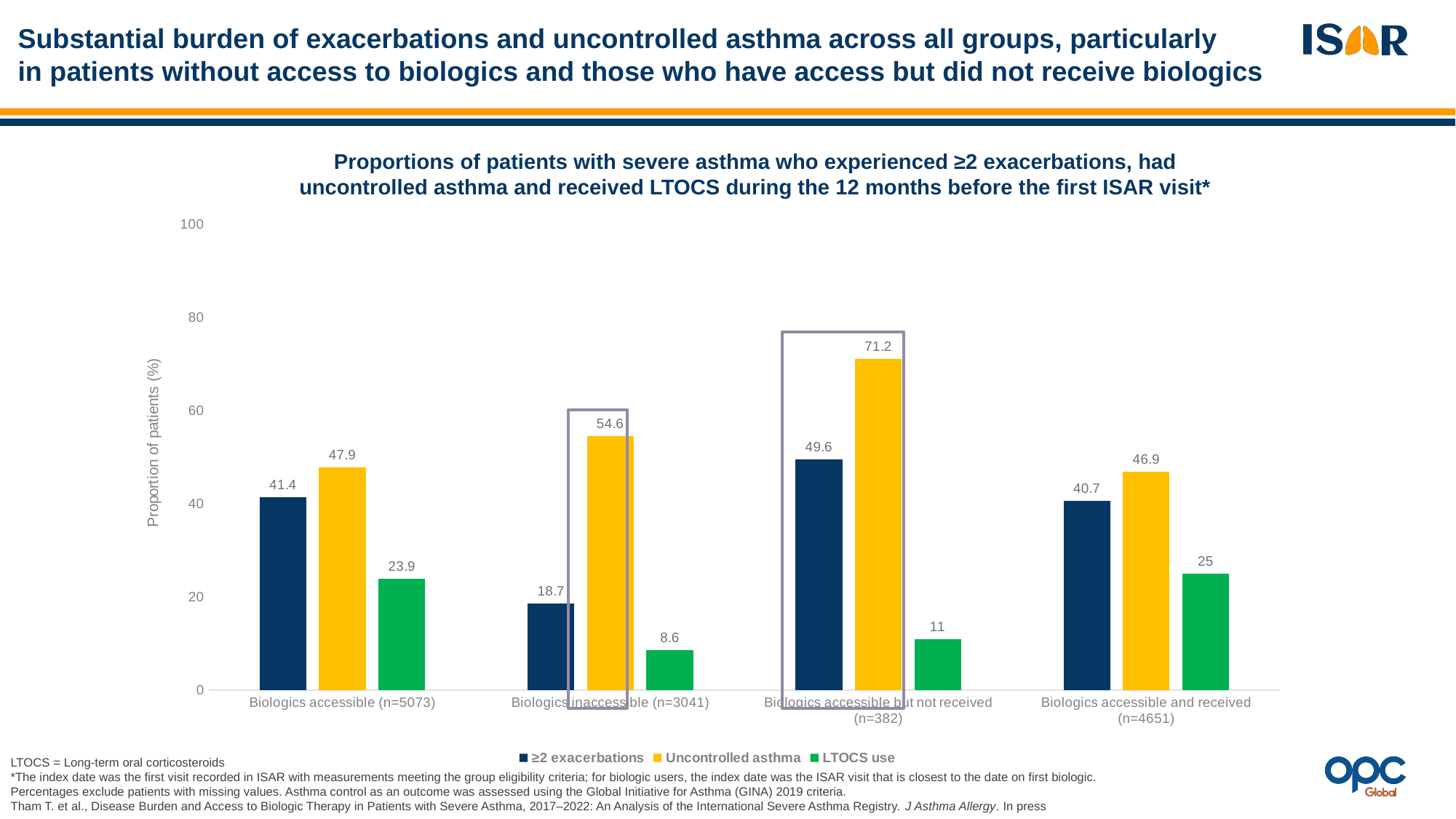
How many series does the legend list? 3 Which is larger: LTOCS use in the Biologics accessible (n=5073) group or LTOCS use in the Biologics accessible and received (n=4651) group? Biologics accessible and received (n=4651) What kind of chart is shown on the slide? Bar chart Which group has the lowest value for ≥2 exacerbations? Biologics inaccessible (n=3041) Which colour represents LTOCS use in the chart? Green What is the value for LTOCS use in the Biologics inaccessible (n=3041) group? 8.6 What is the value for ≥2 exacerbations in the Biologics accessible and received (n=4651) group? 40.7 What is the value for Uncontrolled asthma in the Biologics accessible but not received (n=382) group? 71.2 Is the value for ≥2 exacerbations in the Biologics accessible but not received (n=382) group greater or less than 40? greater What is the difference between the Uncontrolled asthma value and the ≥2 exacerbations value in the Biologics accessible (n=5073) group? 6.5 How many patient groups are shown on the x axis? 4 Which group has the highest value for Uncontrolled asthma? Biologics accessible but not received (n=382)